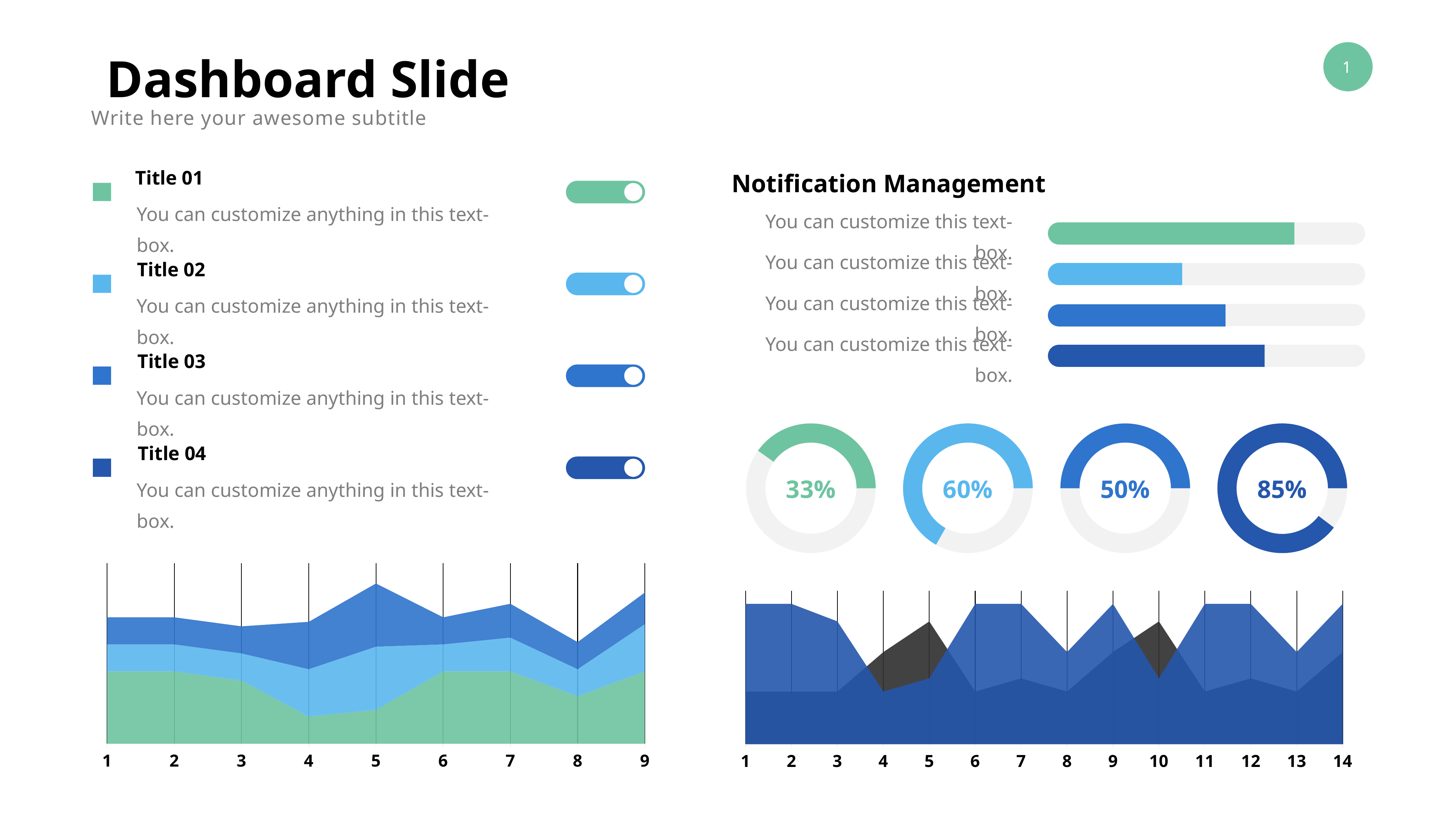
Which is larger, the value in the light blue donut chart or the value in the medium blue donut chart? The light blue donut chart (60%) How many donut charts are shown under Notification Management? 4 What value is shown in the light blue donut chart under Notification Management? 60% How many points are on the x axis of the area chart at the bottom left of the slide? 9 Which of the four donut charts under Notification Management shows the highest value? 85% How many points are on the x axis of the area chart at the bottom right of the slide? 14 What kind of chart is shown at the bottom left of the slide? Area chart What value is shown in the green donut chart under Notification Management? 33% What kind of chart is shown at the bottom right of the slide? Area chart What is the difference between the values of the rightmost donut chart (85%) and the leftmost donut chart (33%)? 52% What value is shown in the dark blue donut chart, the rightmost one under Notification Management? 85% Which of the four donut charts under Notification Management shows the lowest value? 33%